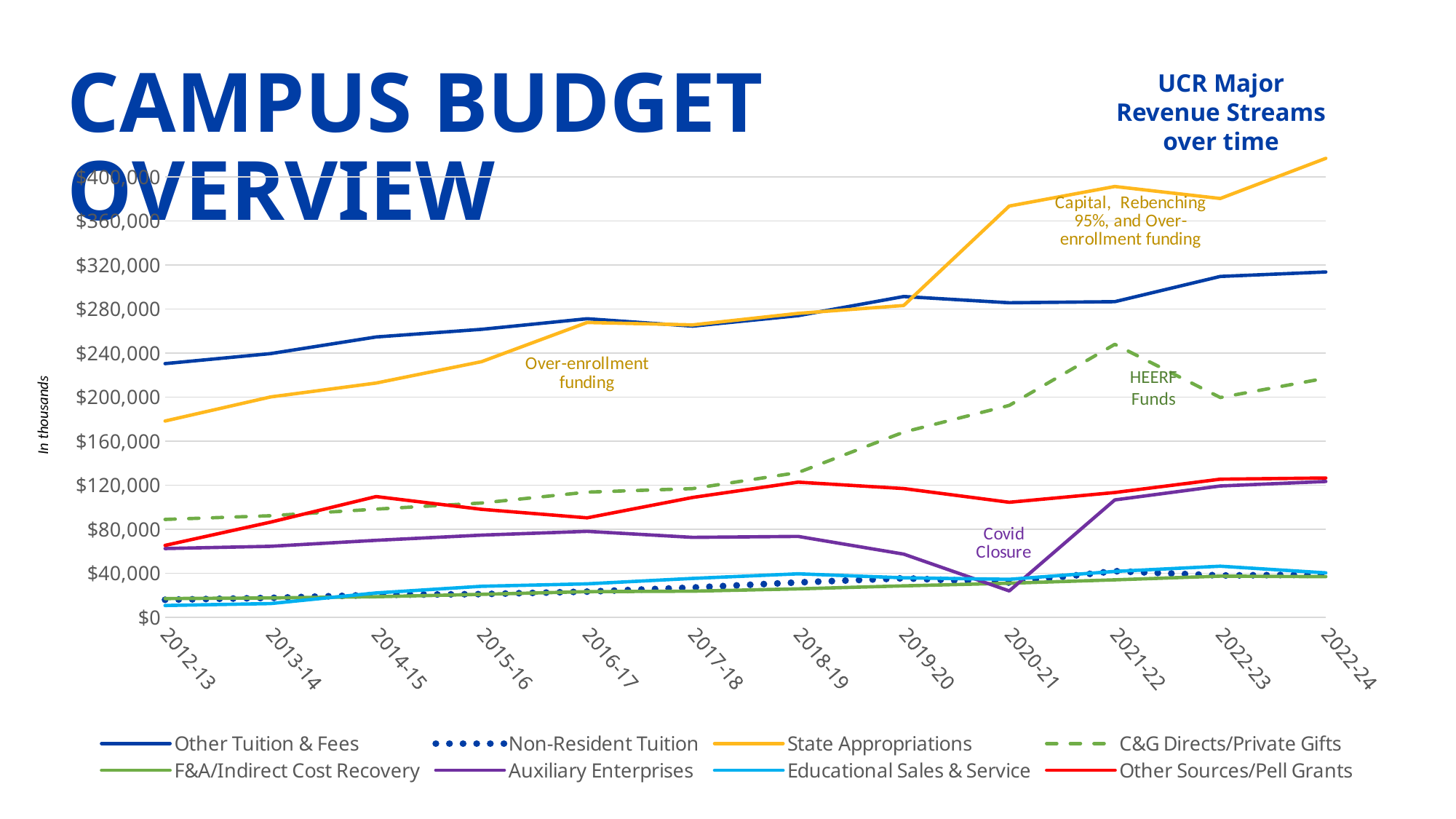
Is the value for Other Tuition & Fees in 2012-13 greater or less than $200,000? greater What kind of chart is shown on the slide? line chart In 2021-22, which is larger: C&G Directs/Private Gifts or Other Sources/Pell Grants? C&G Directs/Private Gifts Which revenue stream has the highest value in 2022-24? State Appropriations Do the values for State Appropriations generally rise or fall from 2012-13 to 2022-24? rise In what units are the values on the y axis expressed, according to the axis label? In thousands In 2012-13, which is larger: Other Tuition & Fees or State Appropriations? Other Tuition & Fees How many series does the legend list? 8 Is the value for State Appropriations in 2022-24 greater or less than $400,000? greater Is the value for Auxiliary Enterprises in 2020-21 greater or less than $40,000? less How many fiscal years are shown along the x axis? 12 What is the title of the chart? UCR Major Revenue Streams over time